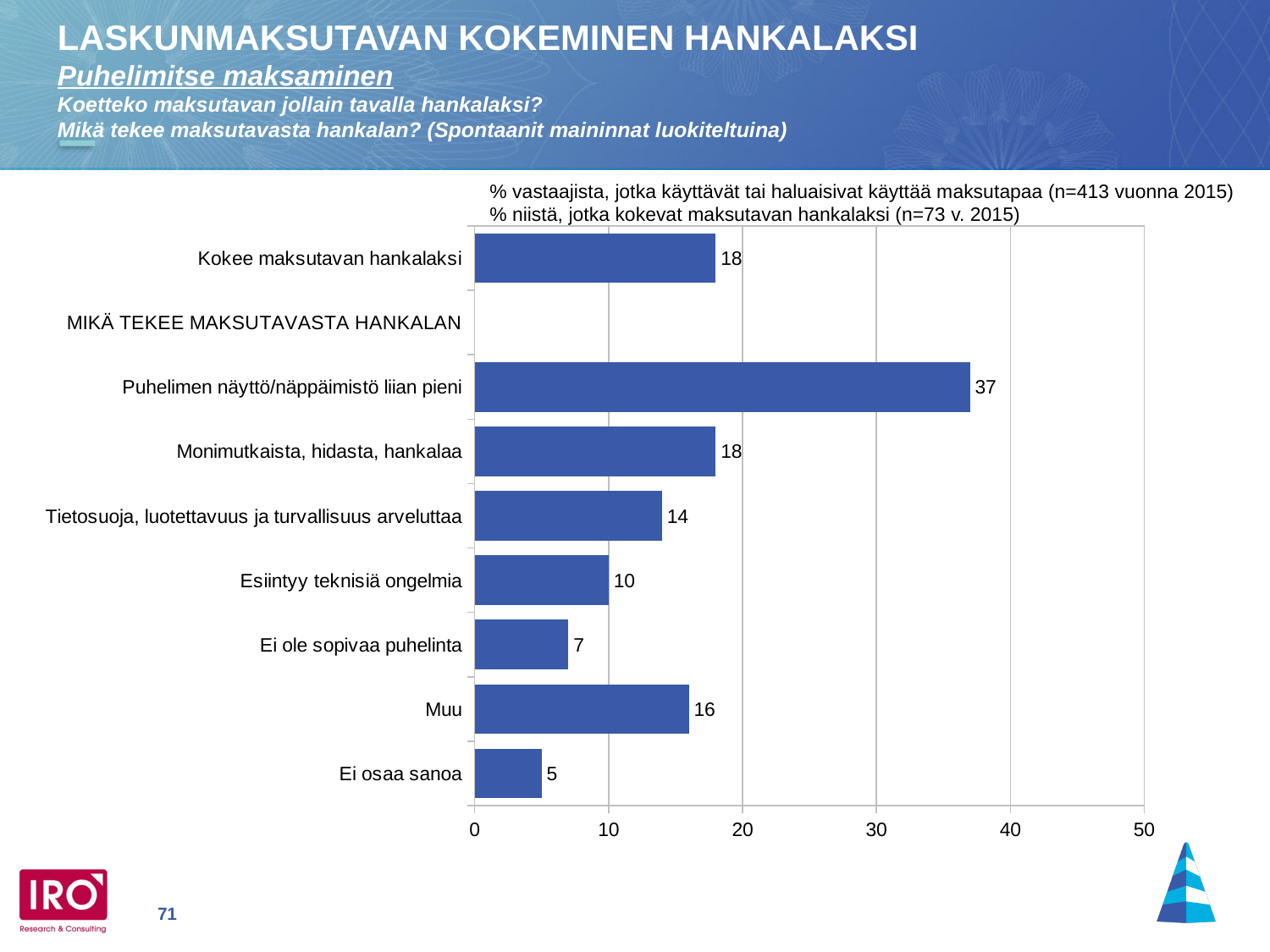
Which category has the highest value? Puhelimen näyttö/näppäimistö liian pieni Which is larger, the value for "Esiintyy teknisiä ongelmia" or the value for "Muu"? Muu What is the difference between the values for "Puhelimen näyttö/näppäimistö liian pieni" and "Monimutkaista, hidasta, hankalaa"? 19 What is the value for "Kokee maksutavan hankalaksi"? 18 What is the value for "Ei ole sopivaa puhelinta"? 7 What is the value for "Muu"? 16 Is the value for "Monimutkaista, hidasta, hankalaa" greater or less than 20? less What is the value for "Tietosuoja, luotettavuus ja turvallisuus arveluttaa"? 14 What kind of chart is shown on the slide? bar chart What is the value for "Puhelimen näyttö/näppäimistö liian pieni"? 37 What is the maximum value shown on the horizontal axis? 50 Which category has the lowest value? Ei osaa sanoa